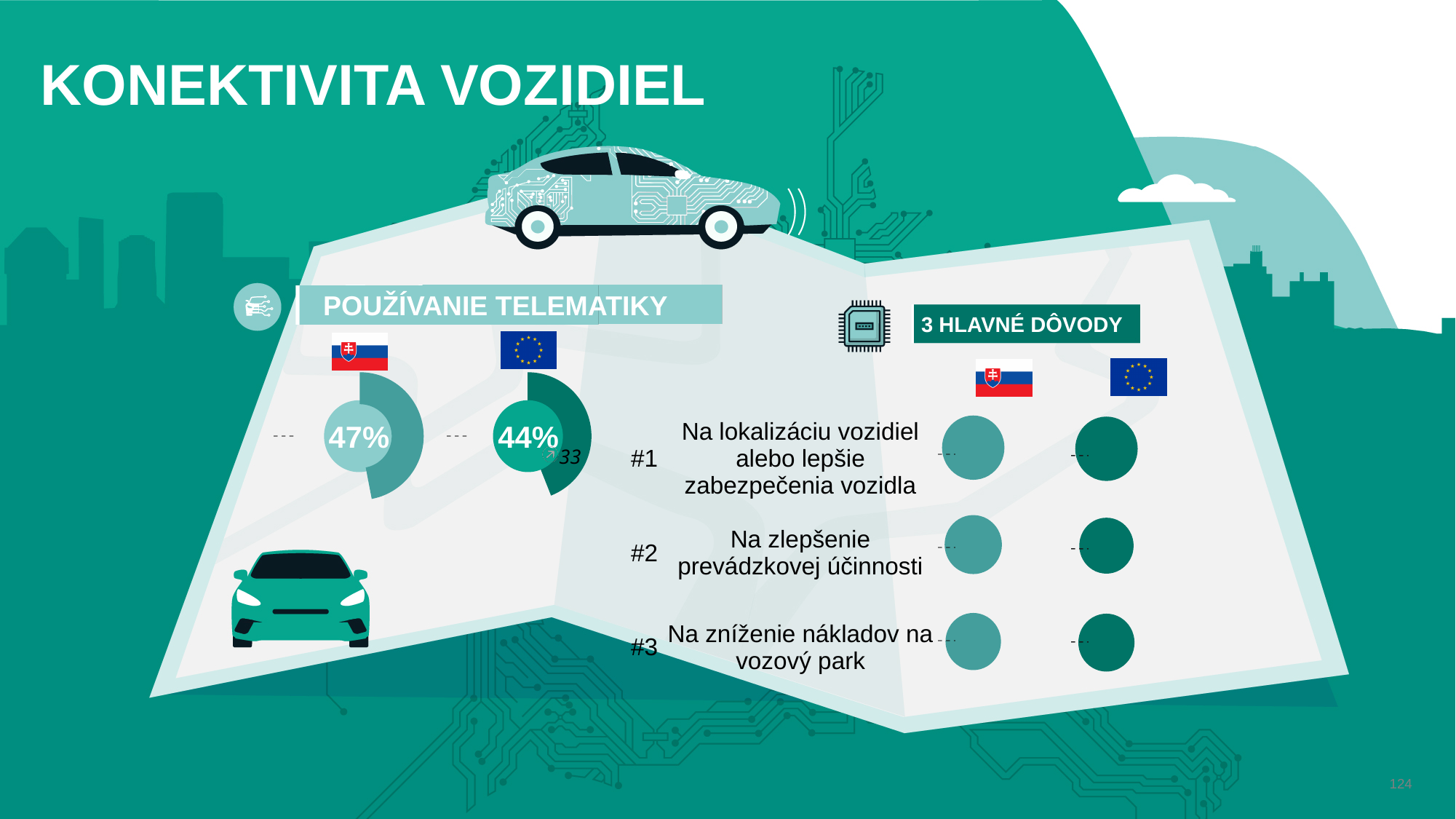
In the 'POUŽÍVANIE TELEMATIKY' charts, what is the value shown for Slovakia (Slovak flag)? 47% In the 'POUŽÍVANIE TELEMATIKY' charts, is the value for Slovakia greater or less than 50%? less What is the title of the slide? KONEKTIVITA VOZIDIEL What kind of chart is used to show the telematics usage values for Slovakia and the EU? Pie chart (donut) What is the heading above the two donut charts on the left side of the slide? POUŽÍVANIE TELEMATIKY How many reasons are listed in the '3 HLAVNÉ DÔVODY' section? 3 What number is printed next to the small arrow beside the EU donut chart? 33 In the 'POUŽÍVANIE TELEMATIKY' charts, what is the difference between the Slovakia value and the EU value? 3 percentage points How many donut charts are shown in the 'POUŽÍVANIE TELEMATIKY' section? 2 In the 'POUŽÍVANIE TELEMATIKY' section, which of the two regions has the lowest value? EU In the 'POUŽÍVANIE TELEMATIKY' charts, which is larger: the value for Slovakia or the value for the EU? Slovakia In the 'POUŽÍVANIE TELEMATIKY' charts, what is the value shown for the EU (EU flag)? 44%